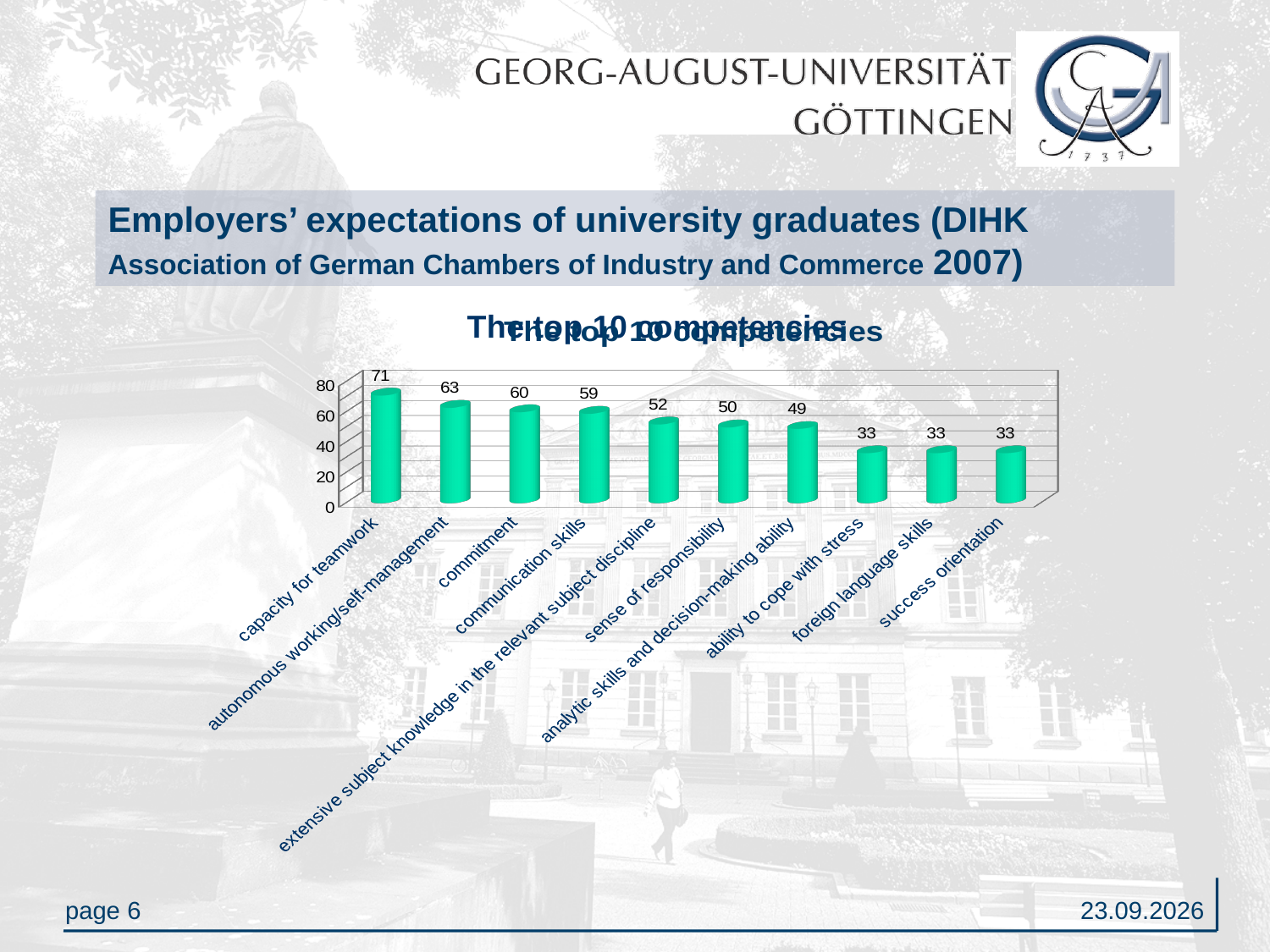
What is the difference between the values for capacity for teamwork and autonomous working/self-management? 8 What is the difference between the values for communication skills and ability to cope with stress? 26 Is the value for extensive subject knowledge in the relevant subject discipline greater or less than 40? greater Which competency has the highest value? capacity for teamwork What value is shown for commitment? 60 How many competencies are shown in the chart? 10 What value is shown for foreign language skills? 33 What value is shown for capacity for teamwork? 71 What is the title of the chart? The top 10 competencies What kind of chart is shown on the slide? bar chart Which is larger, the value for commitment or the value for analytic skills and decision-making ability? commitment What value is shown for sense of responsibility? 50